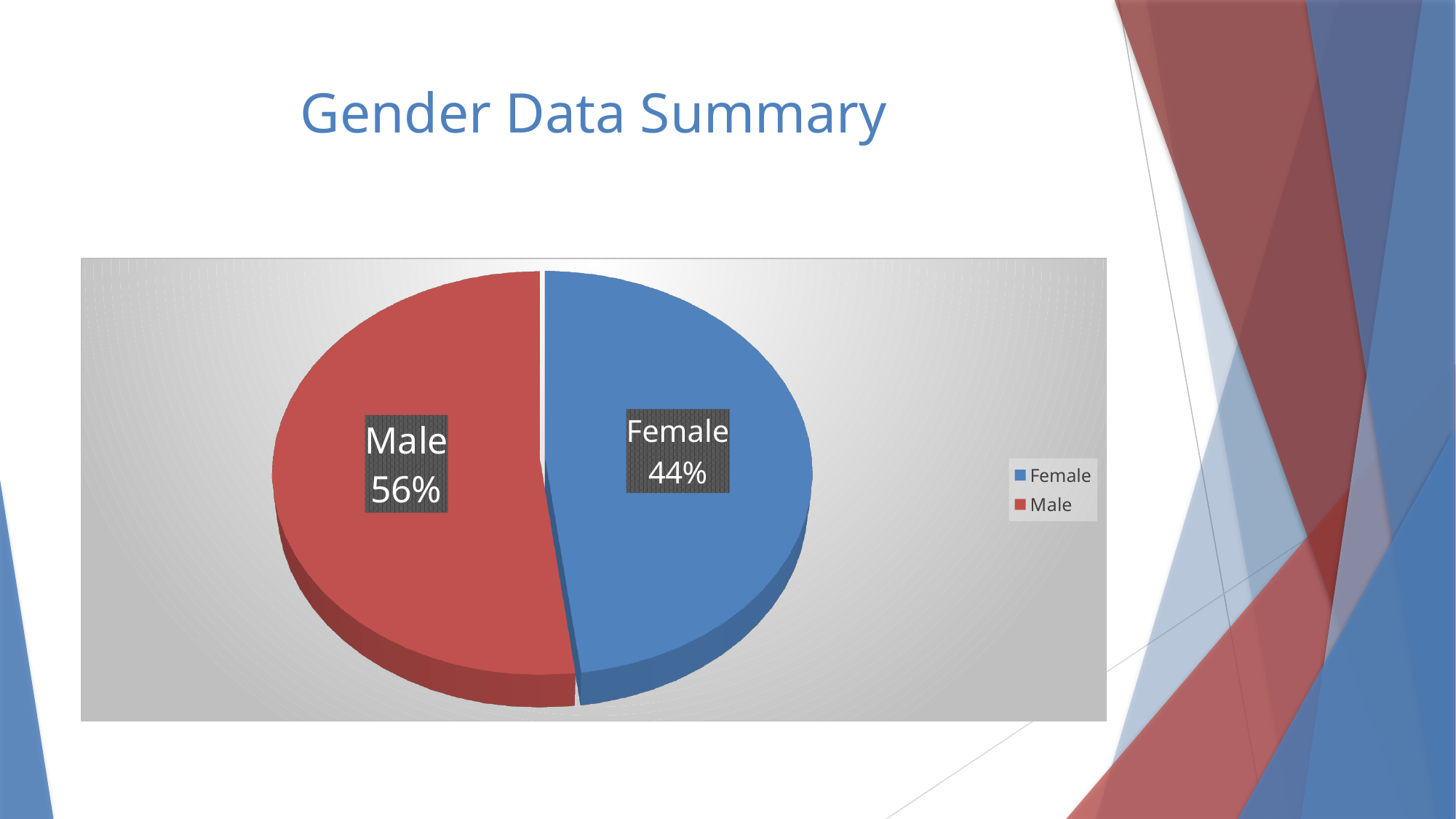
What is the difference in percentage points between the Male and Female slices? 12 How many categories are shown in the pie chart? 2 What is the title of the slide containing the chart? Gender Data Summary What colour is the Female slice of the pie? Blue Which category has the smallest slice of the pie? Female How many entries does the legend list? 2 What share of the pie does the Female slice represent? 44% Which slice is larger, Male or Female? Male What share of the pie does the Male slice represent? 56% What kind of chart is shown on the slide? Pie chart Which category has the largest slice of the pie? Male